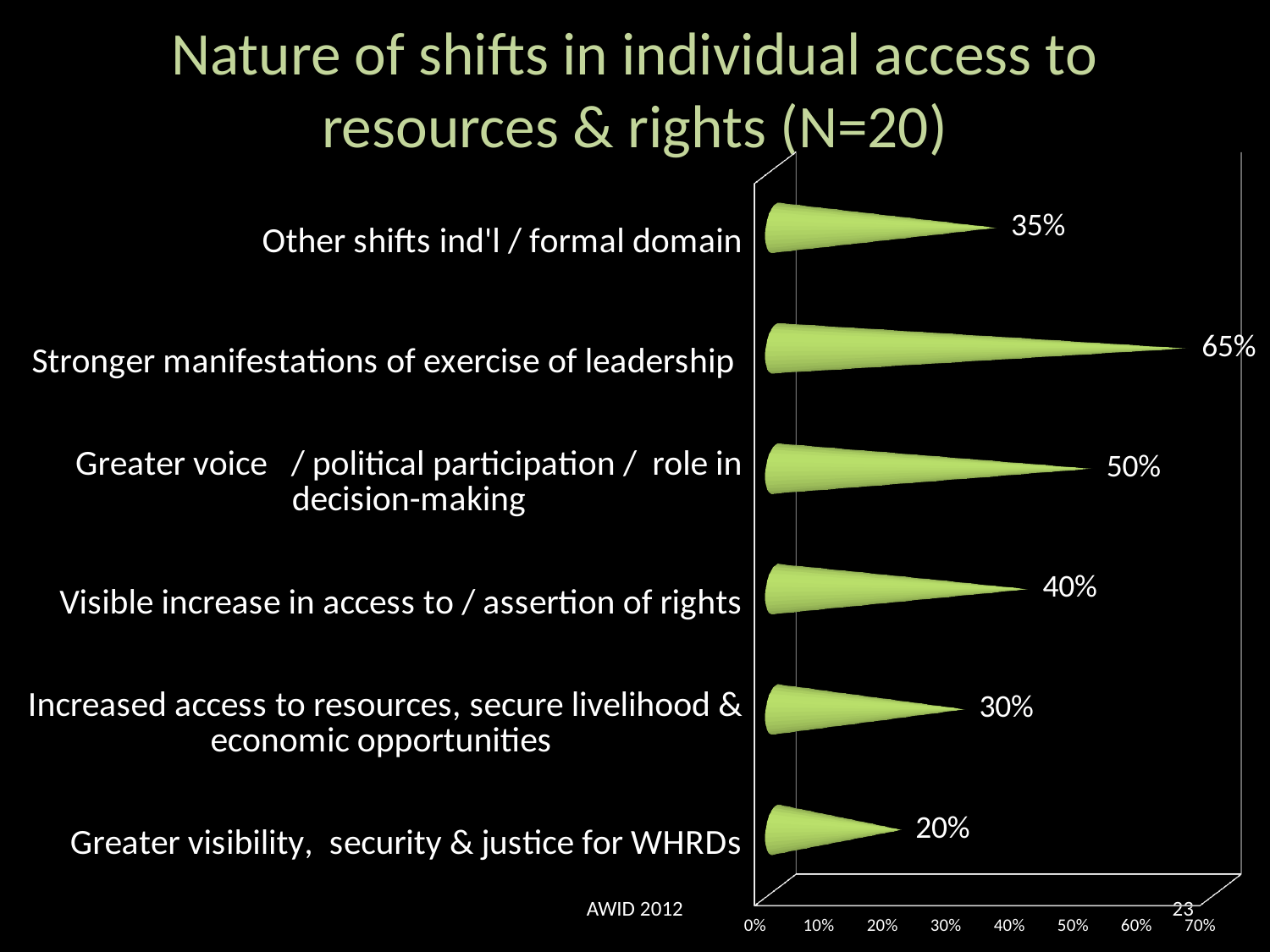
How many categories are shown in the chart? 6 Which category has the highest value? Stronger manifestations of exercise of leadership What is the difference between the values for 'Stronger manifestations of exercise of leadership' and 'Greater voice / political participation / role in decision-making'? 15% What is the value for 'Visible increase in access to / assertion of rights'? 40% What is the value for 'Stronger manifestations of exercise of leadership'? 65% What is the value for 'Greater visibility, security & justice for WHRDs'? 20% What is the title of the chart? Nature of shifts in individual access to resources & rights (N=20) What kind of chart is shown on the slide? Bar chart Which category has the lowest value? Greater visibility, security & justice for WHRDs Which is larger: the value for 'Visible increase in access to / assertion of rights' or 'Increased access to resources, secure livelihood & economic opportunities'? Visible increase in access to / assertion of rights What is the value for 'Other shifts ind'l / formal domain'? 35% What is the highest value shown on the horizontal axis? 70%